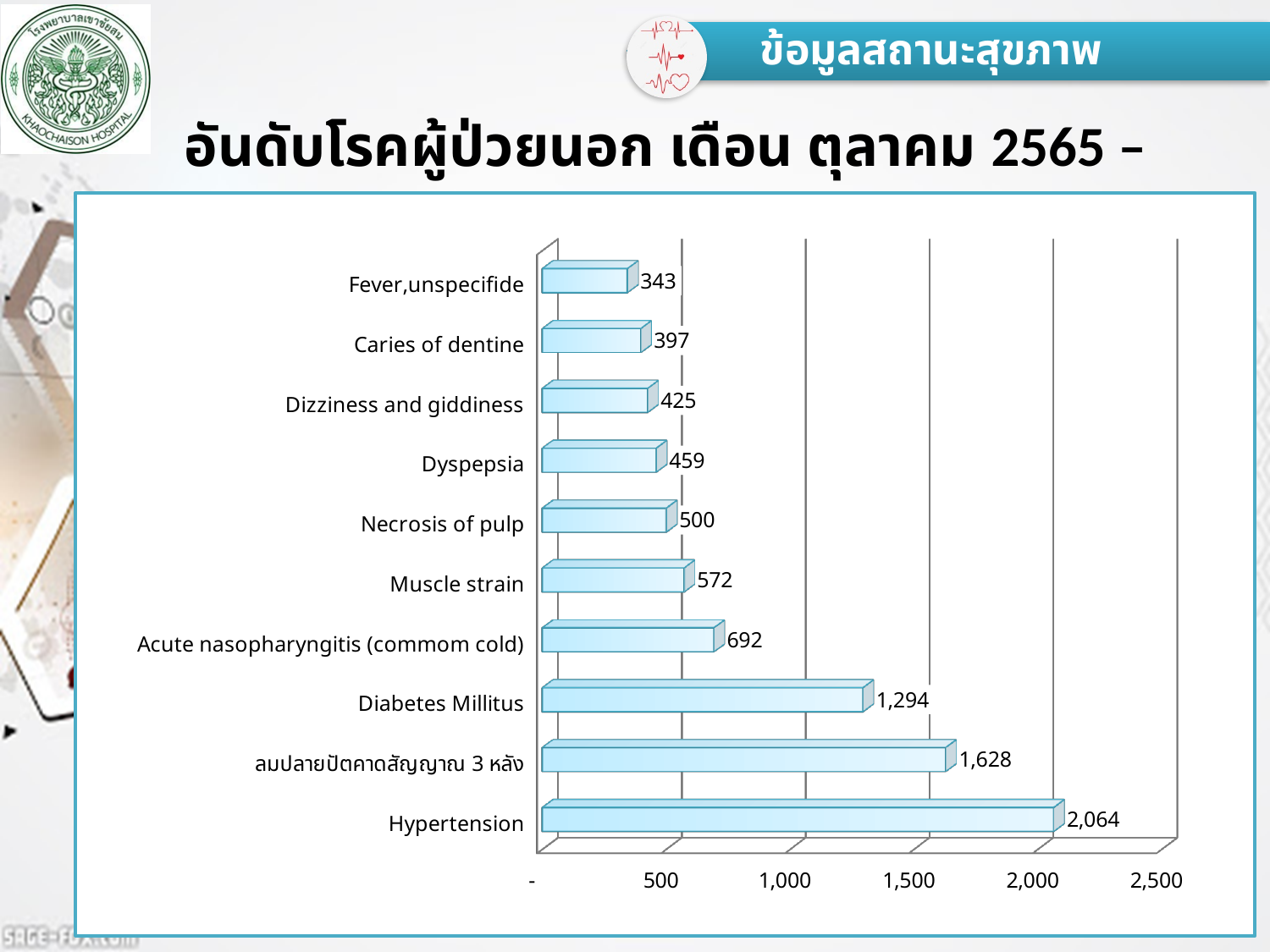
Which category has the lowest value? Fever,unspecifide What is the value for Acute nasopharyngitis (commom cold)? 692 What is the value for Diabetes Millitus? 1,294 What is the value for Muscle strain? 572 What kind of chart is shown on the slide? bar chart Which is larger, the value for Dyspepsia or the value for Necrosis of pulp? Necrosis of pulp What is the value for Hypertension? 2,064 Is the value for Diabetes Millitus greater or less than 1,000? greater What is the difference between the values for Caries of dentine and Fever,unspecifide? 54 Which category has the highest value? Hypertension How many categories are shown in the chart? 10 What is the difference between the values for Hypertension and Diabetes Millitus? 770